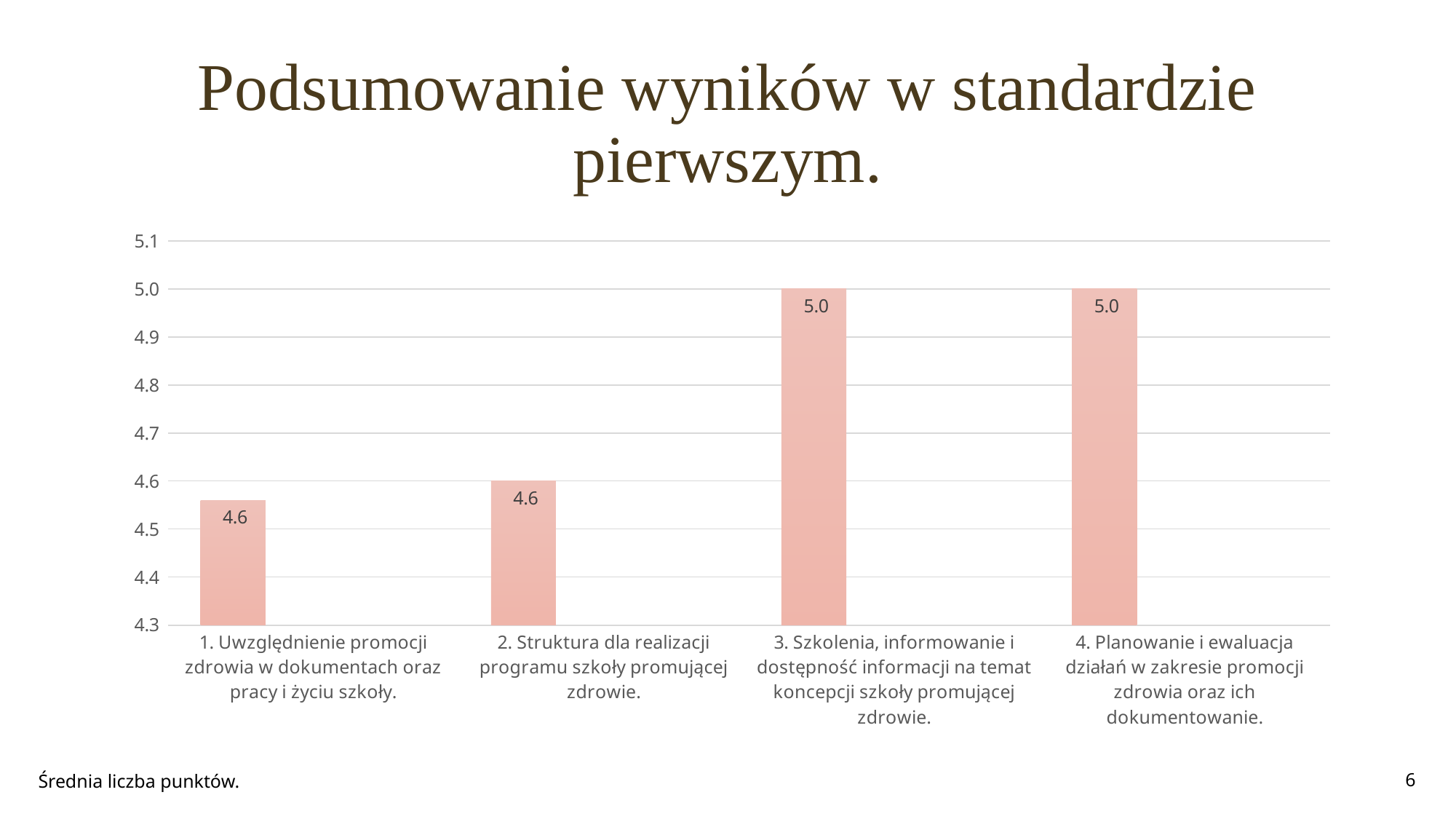
Which has a larger value: category 2 (Struktura dla realizacji programu...) or category 4 (Planowanie i ewaluacja działań...)? 4. Planowanie i ewaluacja działań w zakresie promocji zdrowia oraz ich dokumentowanie. What is the title of the slide containing the chart? Podsumowanie wyników w standardzie pierwszym. What is the value for category "1. Uwzględnienie promocji zdrowia w dokumentach oraz pracy i życiu szkoły."? 4.6 What is the value for category "2. Struktura dla realizacji programu szkoły promującej zdrowie."? 4.6 What is the difference between the value for category 3 (Szkolenia, informowanie...) and category 1 (Uwzględnienie promocji zdrowia...)? 0.4 Is the value for category 1 (Uwzględnienie promocji zdrowia...) greater or less than 4.8? less What kind of chart is shown on the slide? bar chart What is the value for category "4. Planowanie i ewaluacja działań w zakresie promocji zdrowia oraz ich dokumentowanie."? 5.0 Is the value for category 3 (Szkolenia, informowanie...) greater or less than 4.7? greater What is the value for category "3. Szkolenia, informowanie i dostępność informacji na temat koncepcji szkoły promującej zdrowie."? 5.0 What is the highest value shown in the chart? 5.0 How many categories are shown in the chart? 4